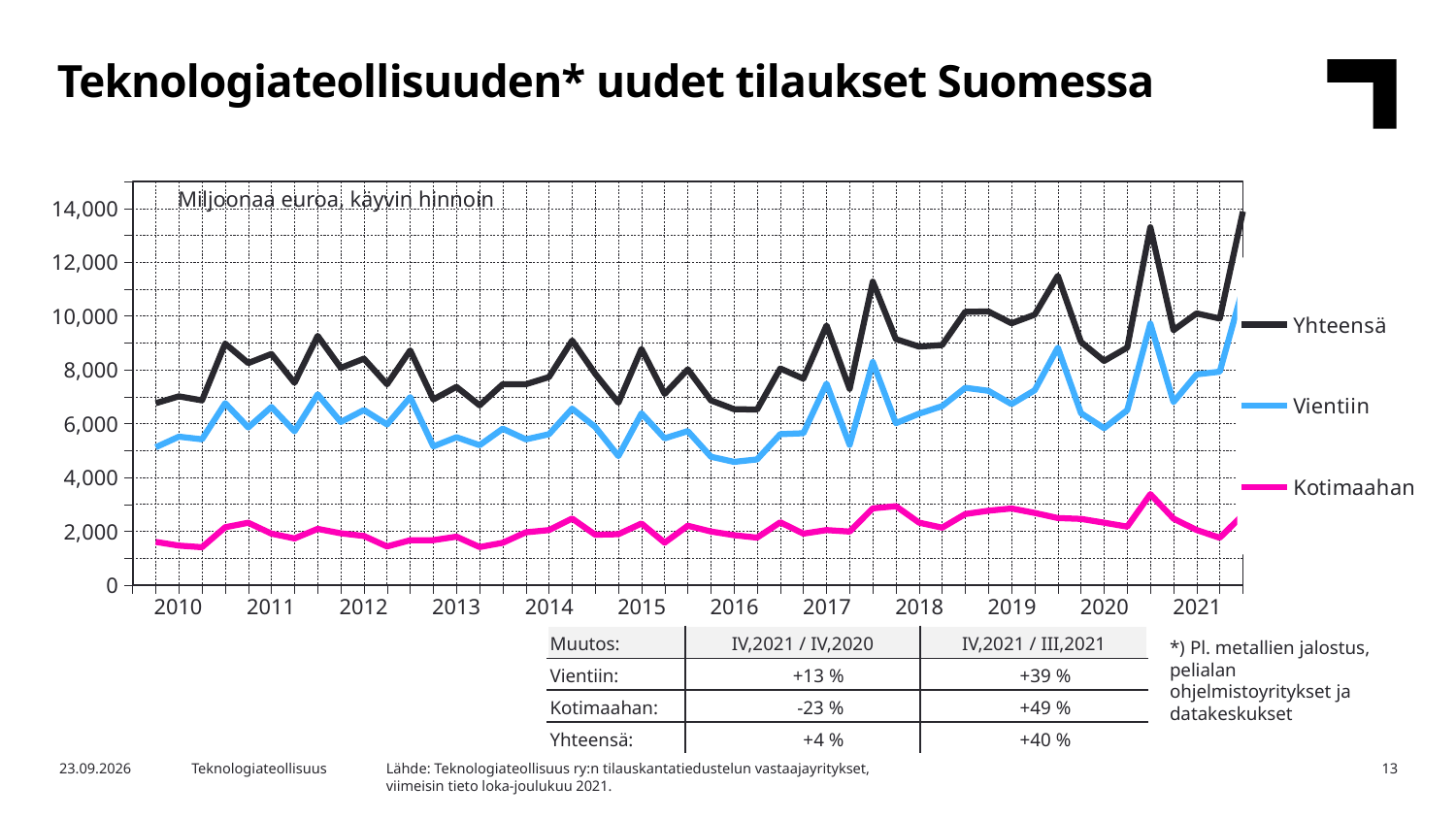
Is the value for Kotimaahan at the last point in 2021 greater or less than 4,000? less Which series has the lowest values throughout the chart? Kotimaahan At the last point in 2021, which is larger, Vientiin or Kotimaahan? Vientiin Is the lowest value for Vientiin in 2016 greater or less than 6,000? less Does the Yhteensä series overall rise or fall from 2016 to 2021? Rise What kind of chart is shown on the slide? Line chart Is the value for Yhteensä at the first point in 2010 greater or less than 8,000? less What unit label is printed inside the chart area? Miljoonaa euroa, käyvin hinnoin Which series has the highest values throughout the chart? Yhteensä What are the three series named in the chart's legend? Yhteensä, Vientiin, Kotimaahan How many series does the chart's legend list? 3